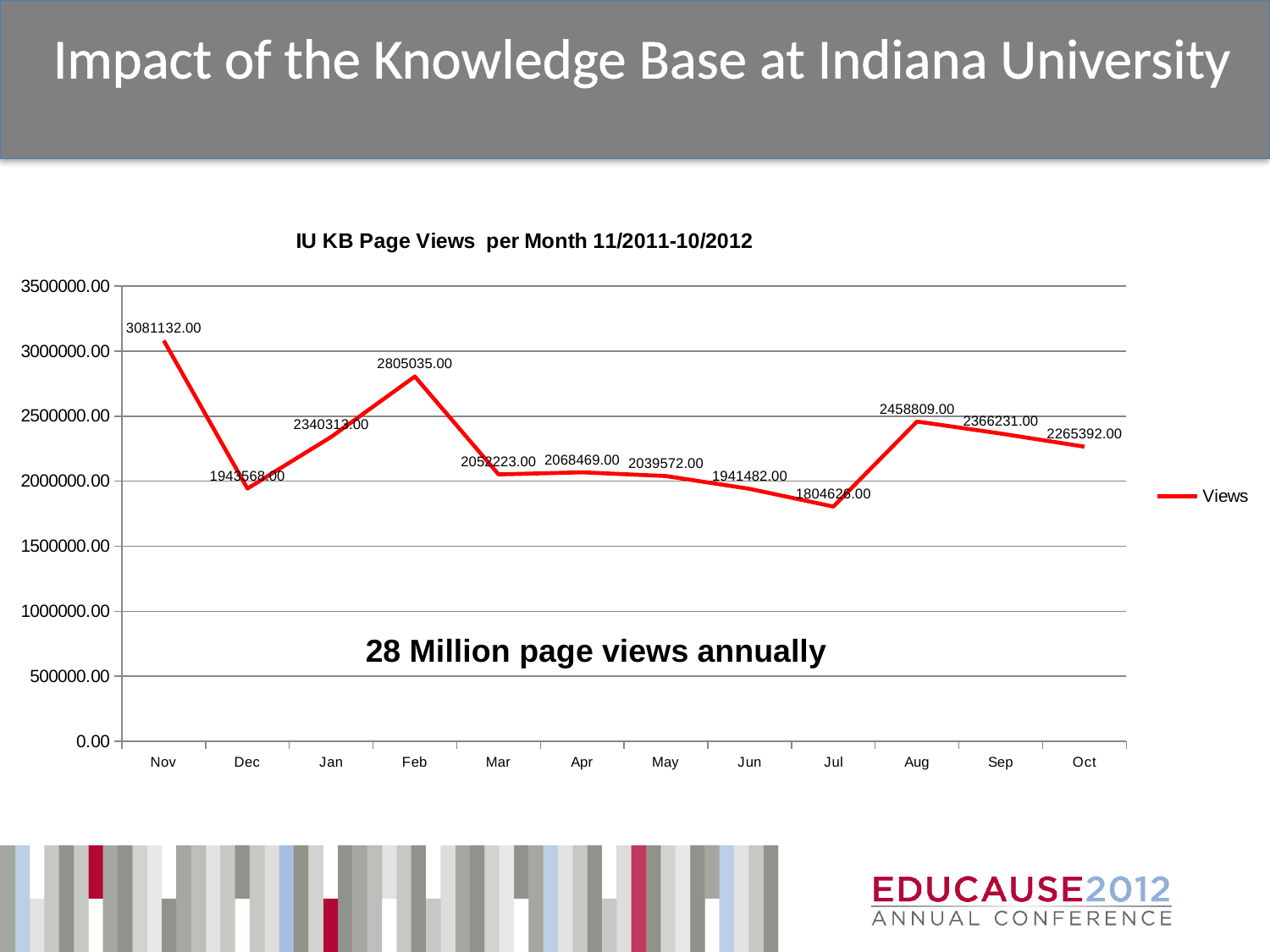
Which month has the lowest number of page views? Jul Is the value for Jul greater or less than 2000000.00? less How many series does the legend list? 1 What is the difference between the values for Nov and Feb? 276097.00 Which is larger, the value for Aug or the value for Oct? Aug How many months are plotted on the x axis? 12 What is the value for Feb? 2805035.00 What is the value for Aug? 2458809.00 What is the value for Nov? 3081132.00 Which month has the highest number of page views? Nov What kind of chart is shown on the slide? line chart What is the title of the chart? IU KB Page Views per Month 11/2011-10/2012